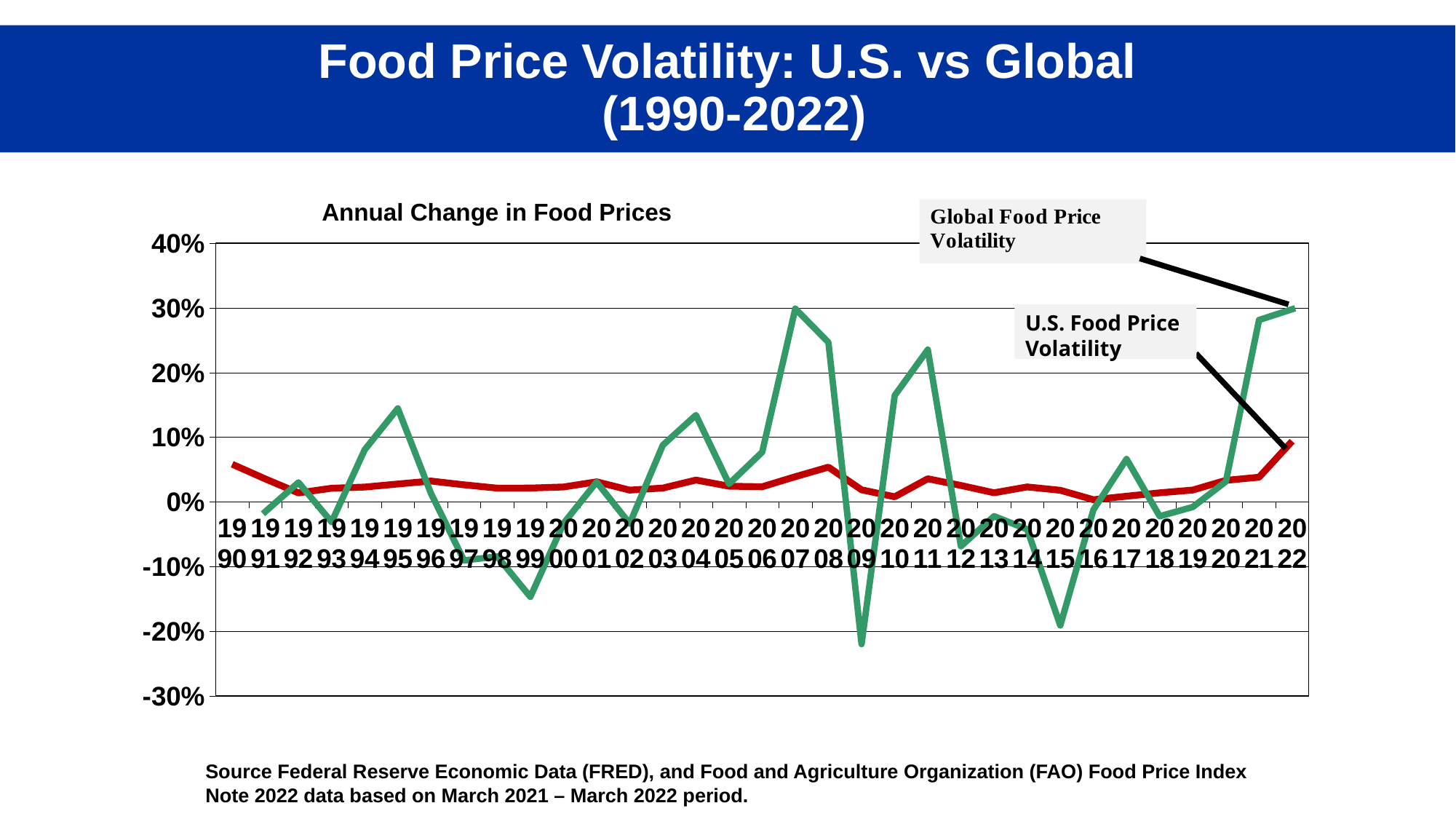
Does the U.S. Food Price Volatility line rise or fall from 2019 to 2022? Rise What colour is the line for Global Food Price Volatility? Green Is the Global Food Price Volatility value for 2007 greater or less than 20%? greater How many data series (lines) are plotted on the chart? 2 In 2009, which series has the larger value: Global Food Price Volatility or U.S. Food Price Volatility? U.S. Food Price Volatility How many years are shown along the x axis of the chart? 33 What is the title printed above the chart's plot area? Annual Change in Food Prices Is the Global Food Price Volatility value for 2009 greater or less than -10%? less What kind of chart is shown on the slide? Line chart In which year does the U.S. Food Price Volatility line reach its highest point? 2022 Is the U.S. Food Price Volatility value for 1990 greater or less than 10%? less In which year does the Global Food Price Volatility line reach its lowest point? 2009